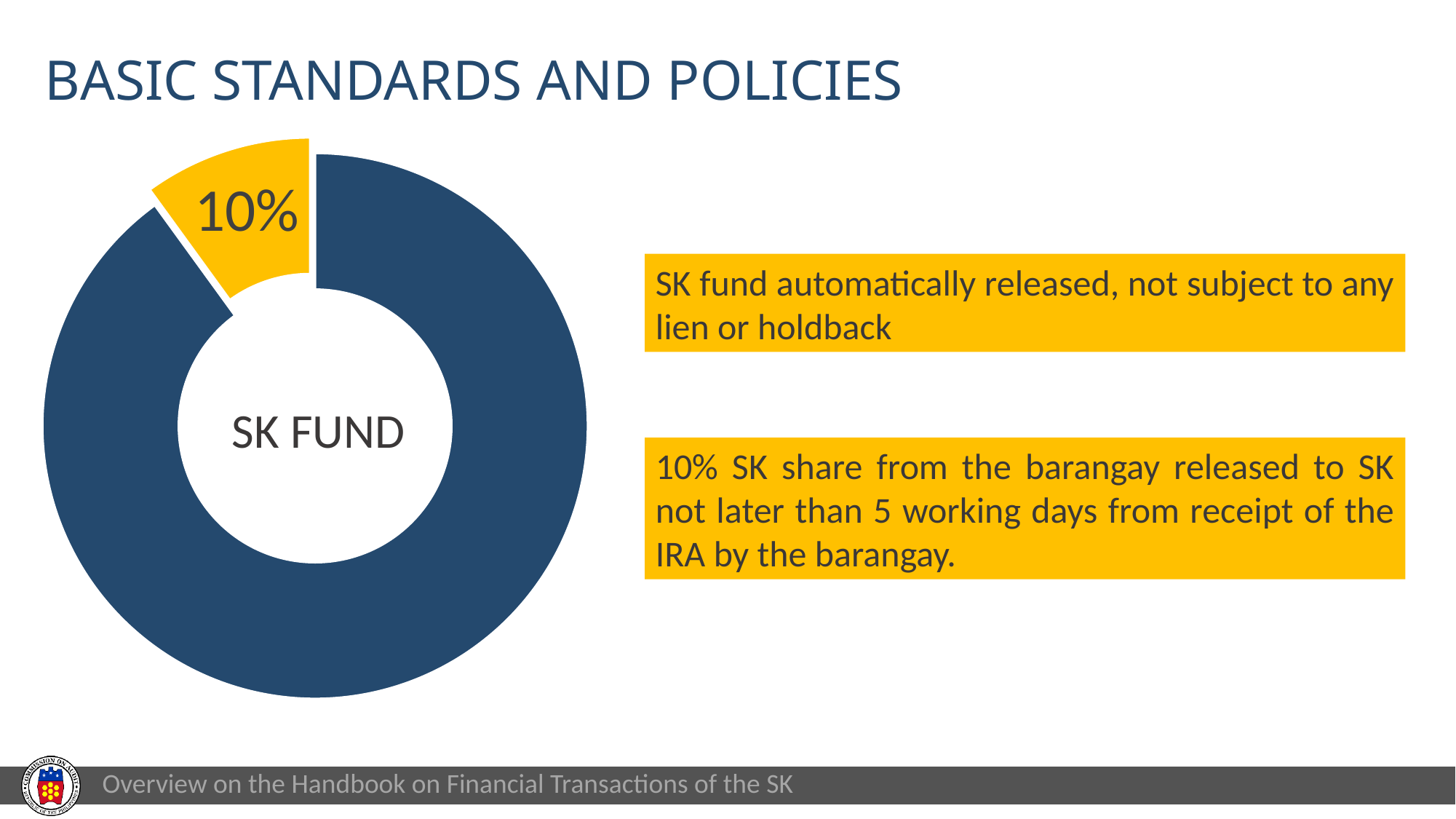
Which slice of the doughnut chart is larger, the dark blue one or the yellow one? the dark blue one What text appears in the centre of the doughnut chart? SK FUND What share of the doughnut chart does the yellow slice represent? 10% How many slices does the doughnut chart have? 2 What percentage is printed on the yellow slice of the doughnut chart? 10% Which slice is the smallest in the doughnut chart? the yellow 10% slice What colour is the slice labelled 10%? yellow What kind of chart is shown on the slide? doughnut (pie) chart Which slice is the largest in the doughnut chart? the dark blue slice Does the yellow slice take up more or less than half of the doughnut chart? less